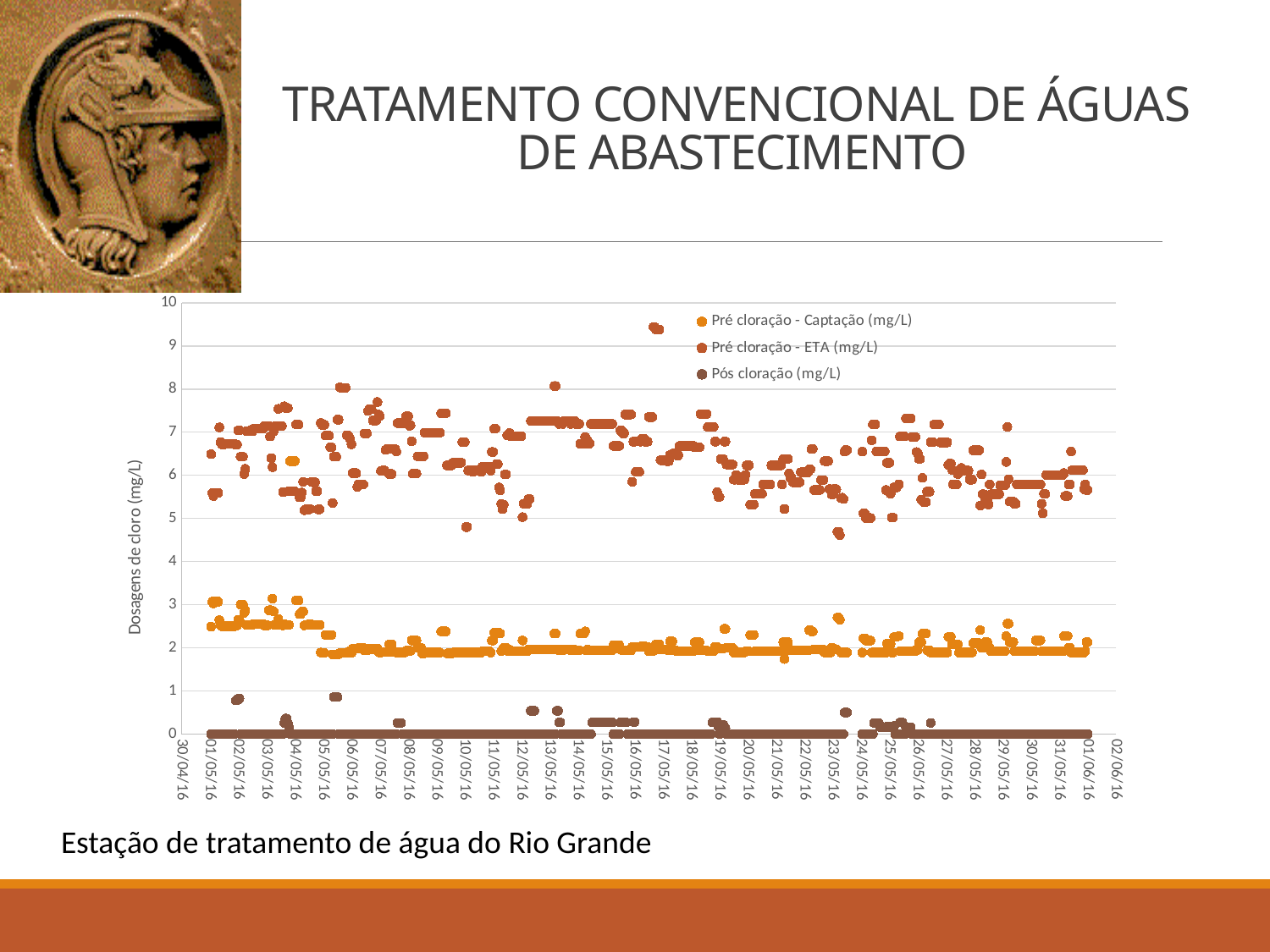
What are the three series named in the chart's legend? Pré cloração - Captação (mg/L), Pré cloração - ETA (mg/L), Pós cloração (mg/L) How many series does the chart's legend list? 3 Do the values of the Pré cloração - Captação (mg/L) series rise or fall from the start of May to the end of May? fall Which series has the lowest values on the chart? Pós cloração (mg/L) Is the highest point of the Pré cloração - ETA (mg/L) series greater or less than 9? greater What is the title of the chart's vertical axis? Dosagens de cloro (mg/L) Which series has the highest values on the chart? Pré cloração - ETA (mg/L) Are the values for the Pós cloração (mg/L) series greater or less than 1? less Which series has higher values, Pré cloração - ETA (mg/L) or Pré cloração - Captação (mg/L)? Pré cloração - ETA (mg/L) Are the values for the Pré cloração - ETA (mg/L) series greater or less than 4? greater What kind of chart is shown on the slide? scatter chart